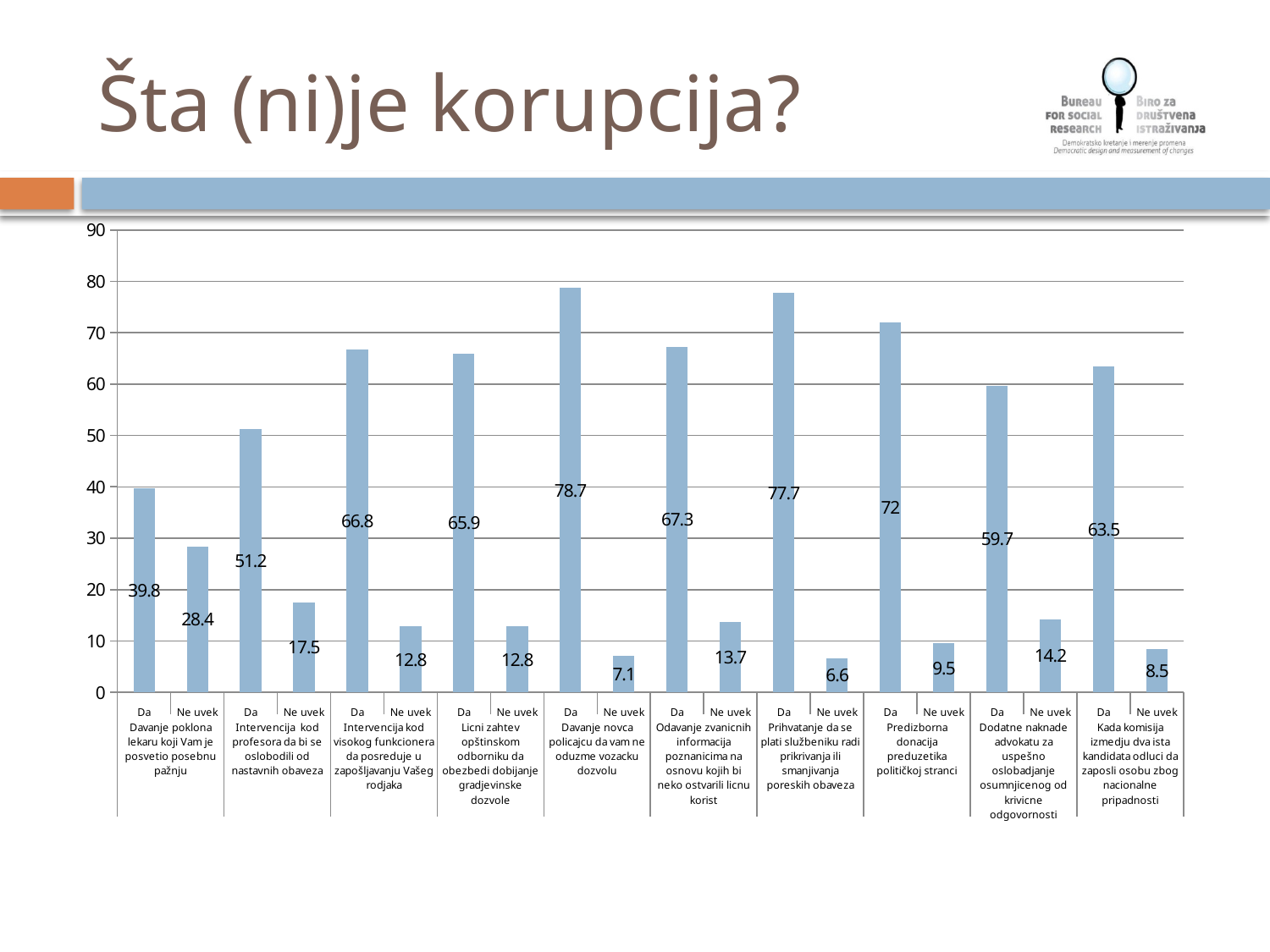
What is the difference between the "Da" and "Ne uvek" values for "Intervencija kod profesora da bi se oslobodili od nastavnih obaveza"? 33.7 Is the "Da" value for "Kada komisija izmedju dva ista kandidata odluci da zaposli osobu zbog nacionalne pripadnosti" greater or less than 60? greater What is the "Ne uvek" value for "Predizborna donacija preduzetika političkoj stranci"? 9.5 What is the "Da" value for "Davanje novca policajcu da vam ne oduzme vozacku dozvolu"? 78.7 Which scenario has the lowest "Ne uvek" value? Prihvatanje da se plati službeniku radi prikrivanja ili smanjivanja poreskih obaveza What is the "Ne uvek" value for "Davanje poklona lekaru koji Vam je posvetio posebnu pažnju"? 28.4 What kind of chart is shown on the slide? Bar chart Which is larger: the "Da" value for "Predizborna donacija preduzetika političkoj stranci" or the "Da" value for "Dodatne naknade advokatu za uspešno oslobadjanje osumnjicenog od krivicne odgovornosti"? Predizborna donacija preduzetika političkoj stranci Which scenario has the highest "Da" value? Davanje novca policajcu da vam ne oduzme vozacku dozvolu What is the title of the slide? Šta (ni)je korupcija? How many bars are plotted in the chart? 20 What is the "Da" value for "Davanje poklona lekaru koji Vam je posvetio posebnu pažnju"? 39.8